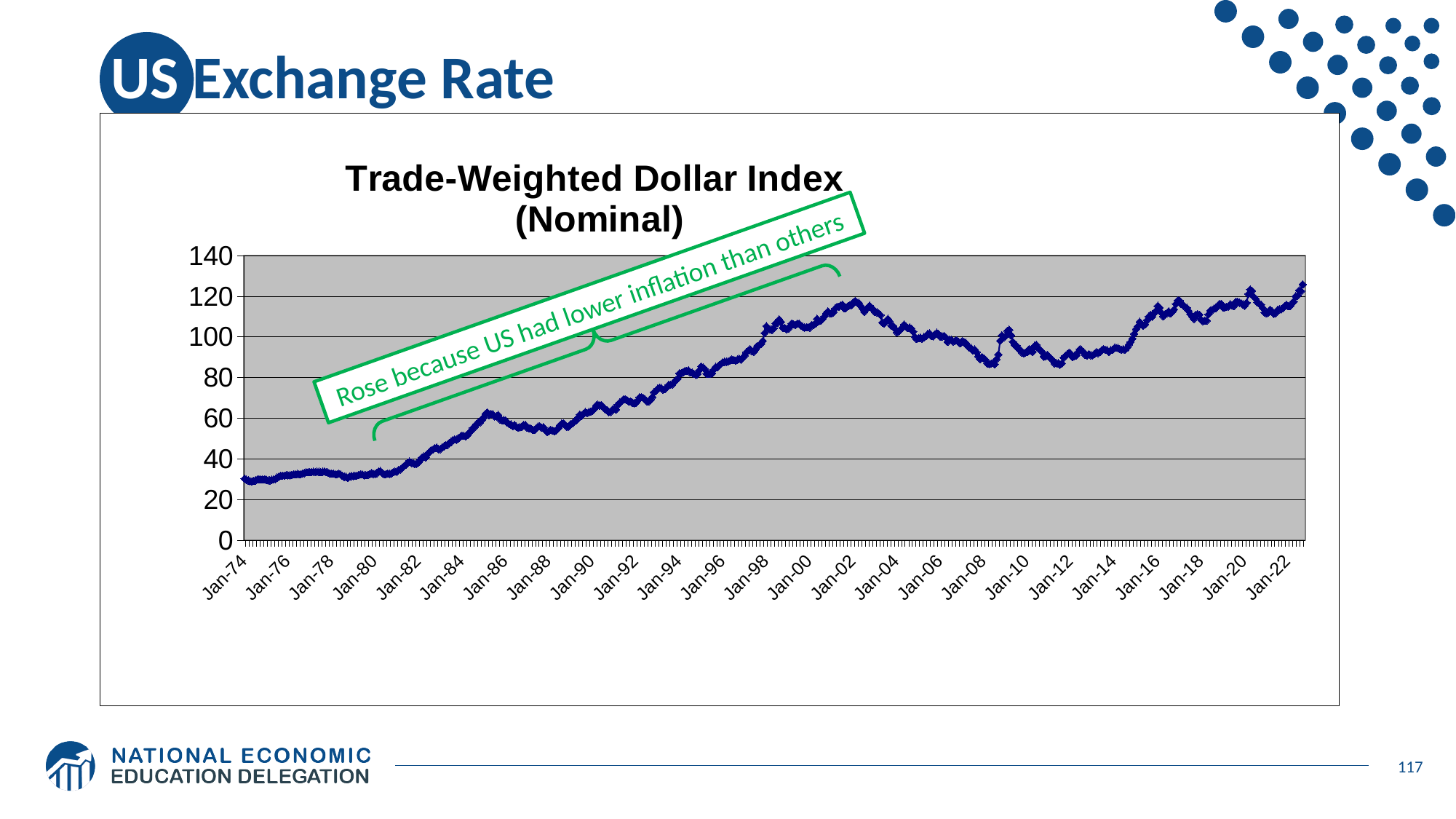
What does the green annotation on the chart say? Rose because US had lower inflation than others What is the highest value shown on the vertical axis? 140 What is the title of the chart? Trade-Weighted Dollar Index (Nominal) Is the value of the index at Jan-90 greater or less than 80? less Is the value of the index at Jan-12 greater or less than 100? less Is the value of the index at Jan-74 greater or less than 40? less Which is higher, the index value at Jan-02 or at Jan-08? Jan-02 Which is higher, the index value at Jan-02 or at Jan-74? Jan-02 What kind of chart is shown on the slide? line chart Overall, does the index rise or fall from Jan-74 to the end of the series? rise